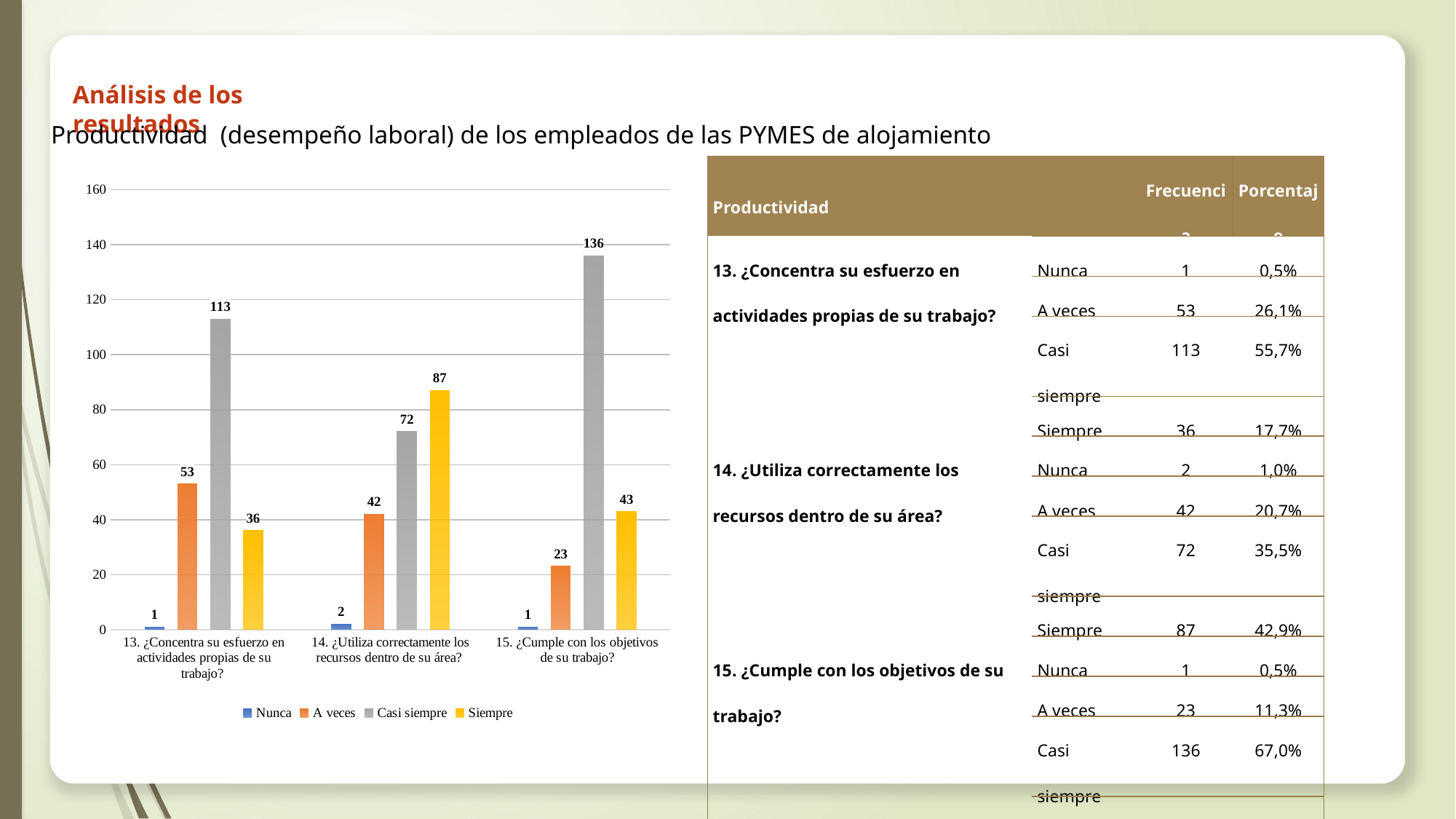
Is the 'Casi siempre' value for question 14 greater or less than 80? less What is the difference between the 'Casi siempre' values for question 15 and question 13? 23 What is the value of 'A veces' for question 13 (¿Concentra su esfuerzo en actividades propias de su trabajo?)? 53 Which legend entry is shown in yellow? Siempre Which is larger: 'Siempre' for question 13 or 'Siempre' for question 15? Siempre for question 15 What is the value of 'Siempre' for question 14 (¿Utiliza correctamente los recursos dentro de su área?)? 87 How many series does the chart legend list? 4 Which question category has the highest 'Casi siempre' value? 15. ¿Cumple con los objetivos de su trabajo? Which series has the lowest value for question 14? Nunca How many question categories are shown on the x axis of the chart? 3 What type of chart is shown on the slide? bar chart What is the value of 'Casi siempre' for question 15 (¿Cumple con los objetivos de su trabajo?)? 136